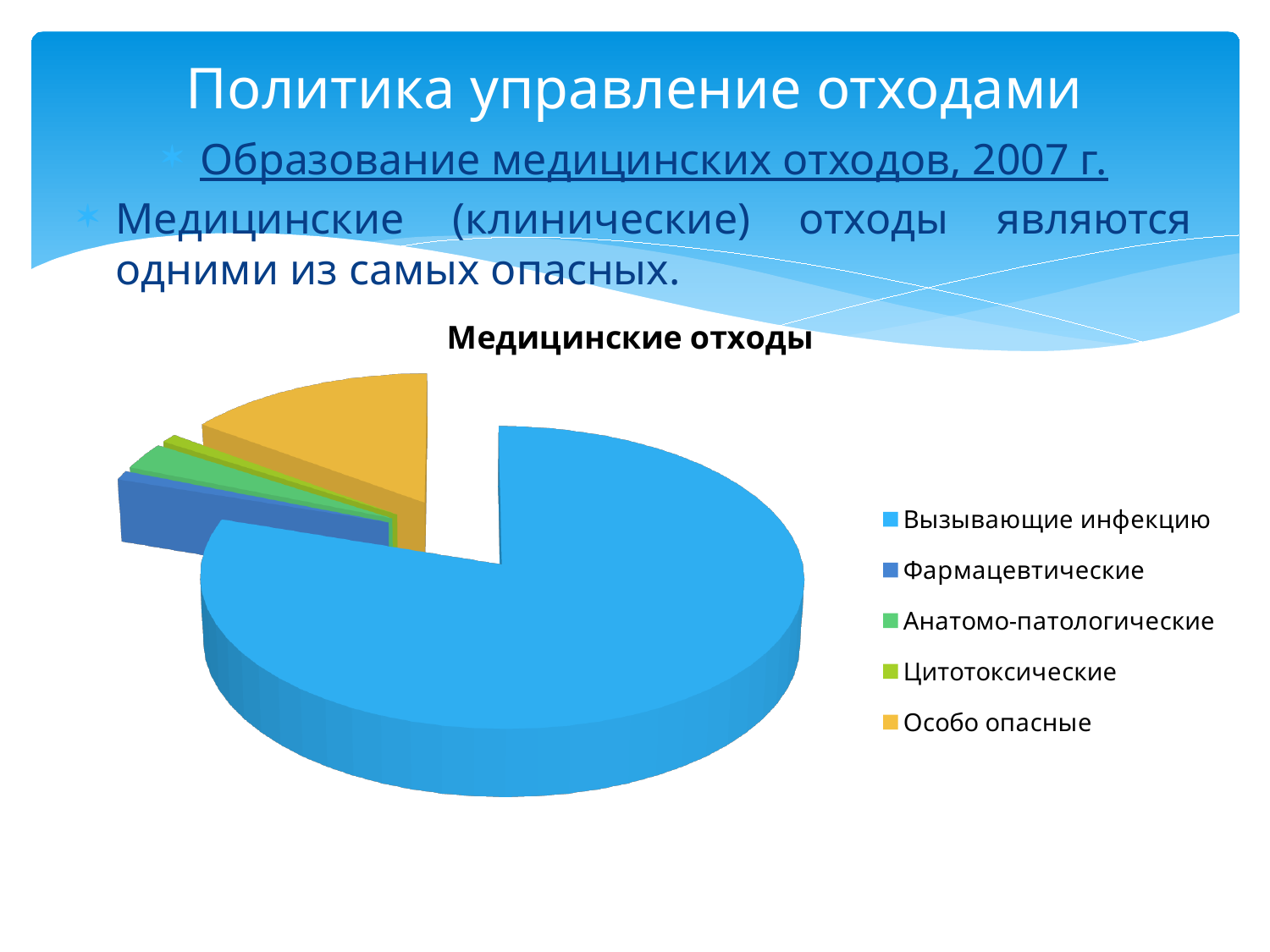
Which category is shown in yellow in the legend? Особо опасные Which is larger: the slice for Особо опасные or the slice for Анатомо-патологические? Особо опасные Which category has the largest slice of the pie? Вызывающие инфекцию Which is larger: the slice for Особо опасные or the slice for Фармацевтические? Особо опасные What is the title of the chart? Медицинские отходы Which category has the second-largest slice of the pie? Особо опасные How many categories does the pie chart show? 5 What kind of chart is shown on the slide? pie chart Which is larger: the slice for Вызывающие инфекцию or the slice for Особо опасные? Вызывающие инфекцию